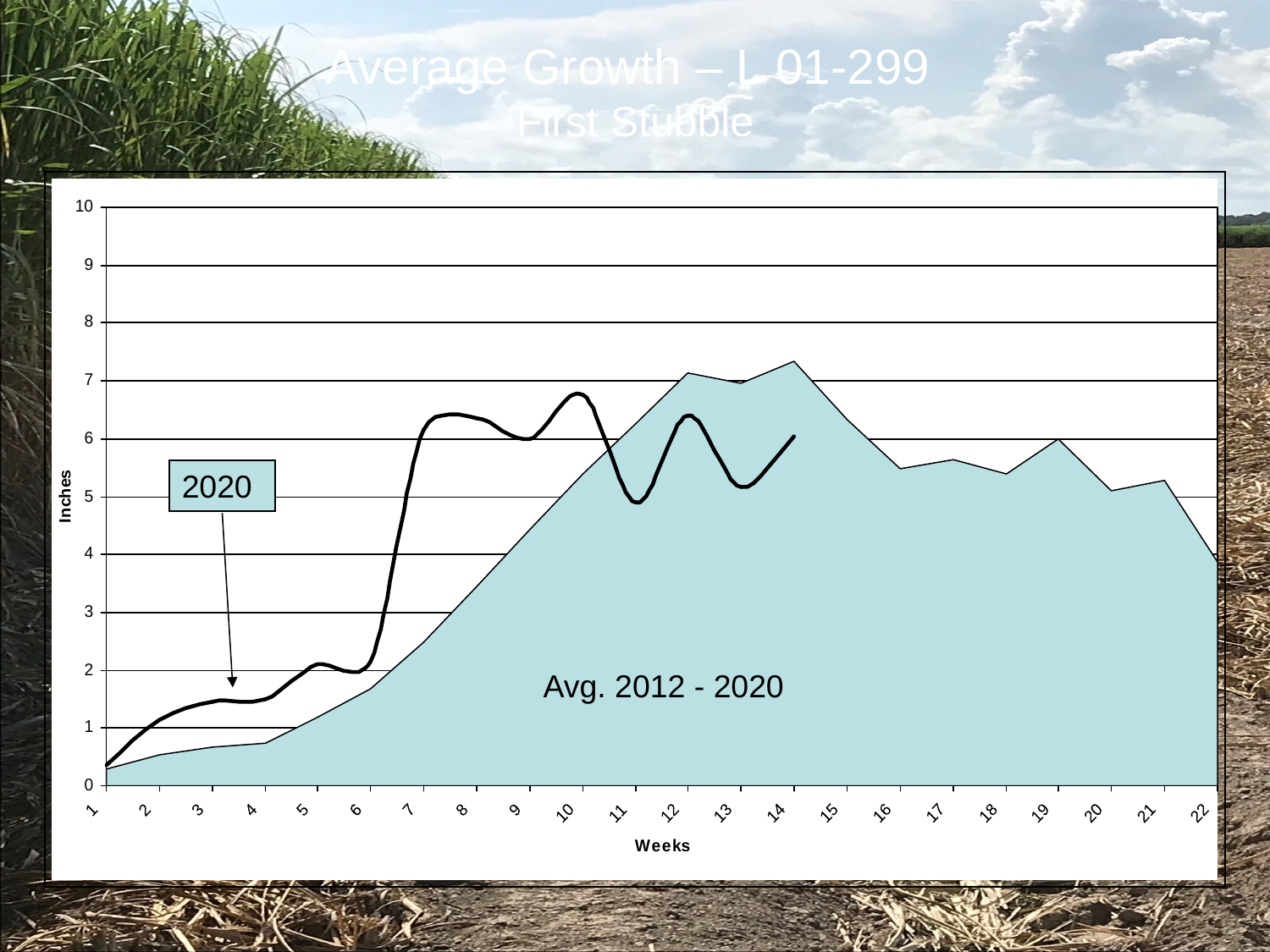
How many data series are plotted on the chart? 2 Is the Avg. 2012 - 2020 value at week 6 greater or less than 2? less Is the Avg. 2012 - 2020 value at week 22 greater or less than 5? less Is the 2020 value at week 7 greater or less than 6? greater At week 7, which series has the higher value, 2020 or Avg. 2012 - 2020? 2020 At week 14, which series has the higher value, 2020 or Avg. 2012 - 2020? Avg. 2012 - 2020 What is the label on the vertical axis? Inches What is the title of the chart on the slide? Average Growth – L 01-299 First Stubble Does the Avg. 2012 - 2020 series rise or fall from week 1 to week 14? rise What kind of chart is this? Area chart with a line overlay How many weeks are shown along the x axis? 22